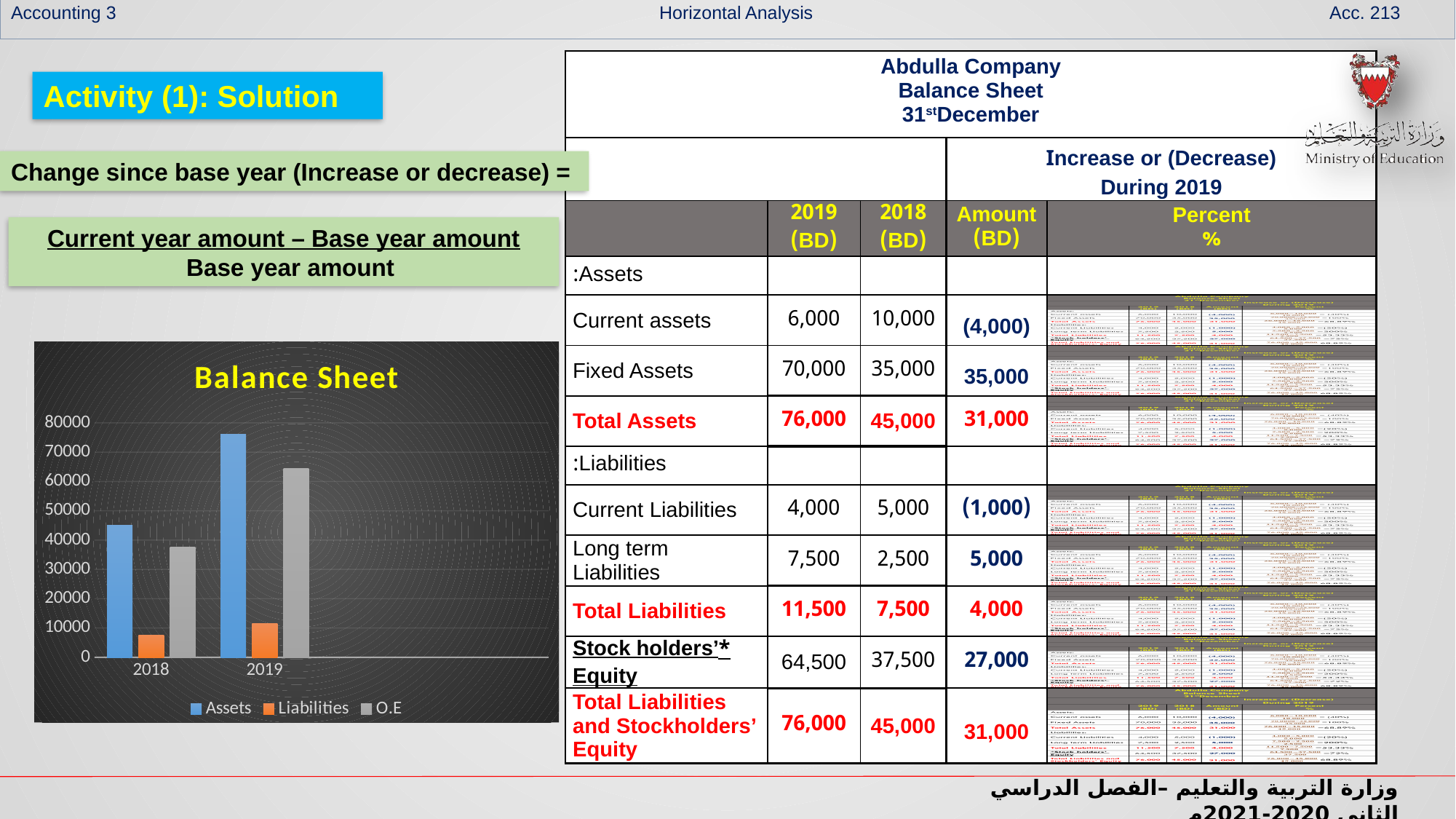
How many series does the legend of the "Balance Sheet" chart list? 3 How many year categories are shown on the x axis of the "Balance Sheet" chart? 2 In the "Balance Sheet" chart, which series has the tallest bar for 2019? Assets What kind of chart is the "Balance Sheet" chart on the slide? bar chart What is the title of the chart on the slide? Balance Sheet In the "Balance Sheet" chart, do the O.E values rise or fall from 2018 to 2019? rise In the "Balance Sheet" chart, is the Assets value for 2019 greater or less than 70000? greater In the "Balance Sheet" chart, is the Liabilities value for 2018 greater or less than 10000? less In the "Balance Sheet" chart, is the Assets bar larger for 2018 or for 2019? 2019 What are the three legend entries of the "Balance Sheet" chart? Assets, Liabilities, O.E In the "Balance Sheet" chart, which series has the shortest bar for 2018? Liabilities In the "Balance Sheet" chart, is the O.E value for 2019 greater or less than 60000? greater